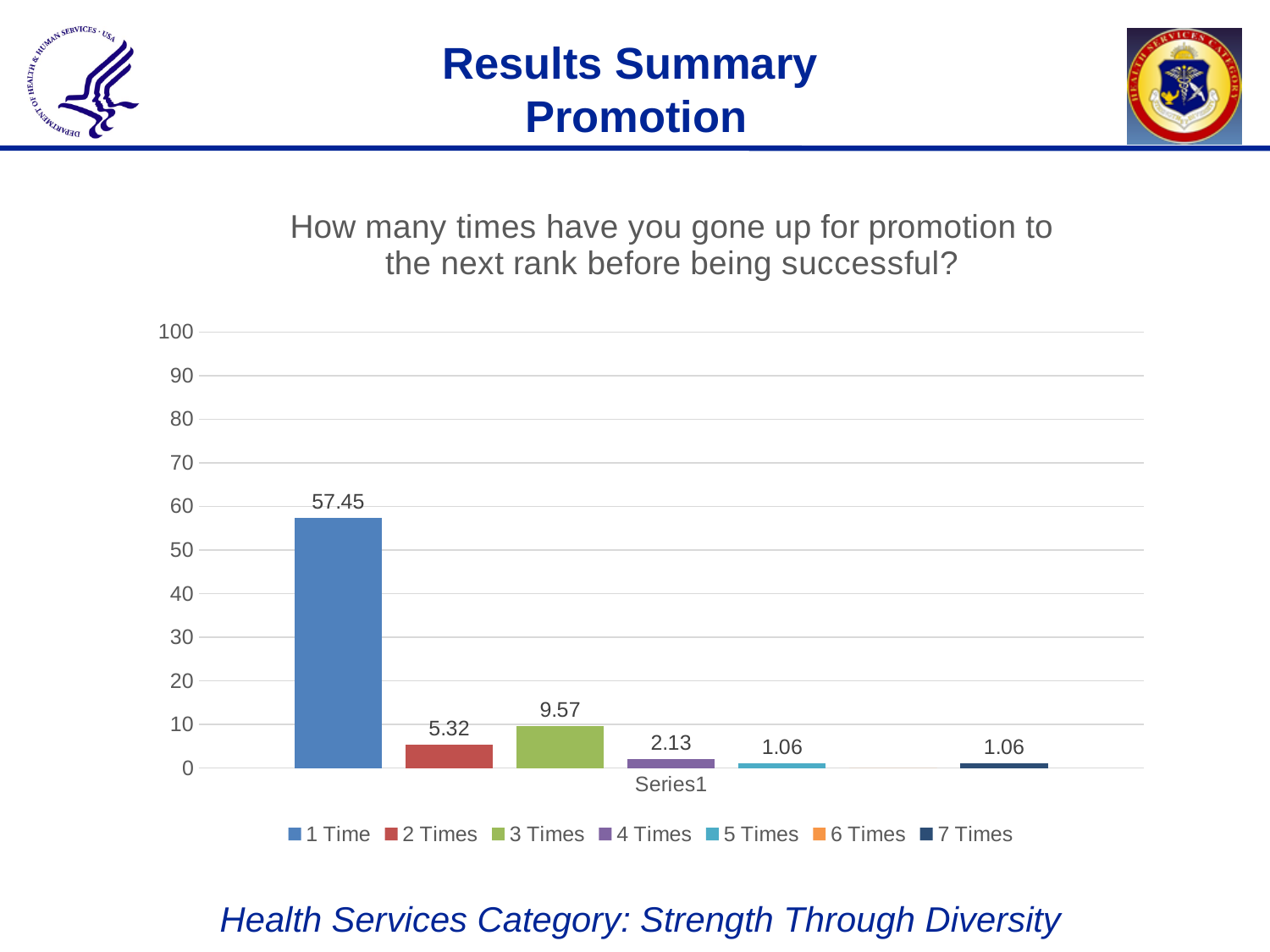
What is the value for 5 Times? 1.06 How many entries does the legend list? 7 What is the difference between the values for 1 Time and 3 Times? 47.88 What is the value for 1 Time? 57.45 What kind of chart is shown on the slide? bar chart What is the value for 4 Times? 2.13 What is the difference between the values for 3 Times and 2 Times? 4.25 What is the value for 2 Times? 5.32 What is the value for 3 Times? 9.57 Is the value for 1 Time greater or less than 50? greater Which is larger, the value for 2 Times or the value for 3 Times? 3 Times Which legend entry has the highest value? 1 Time